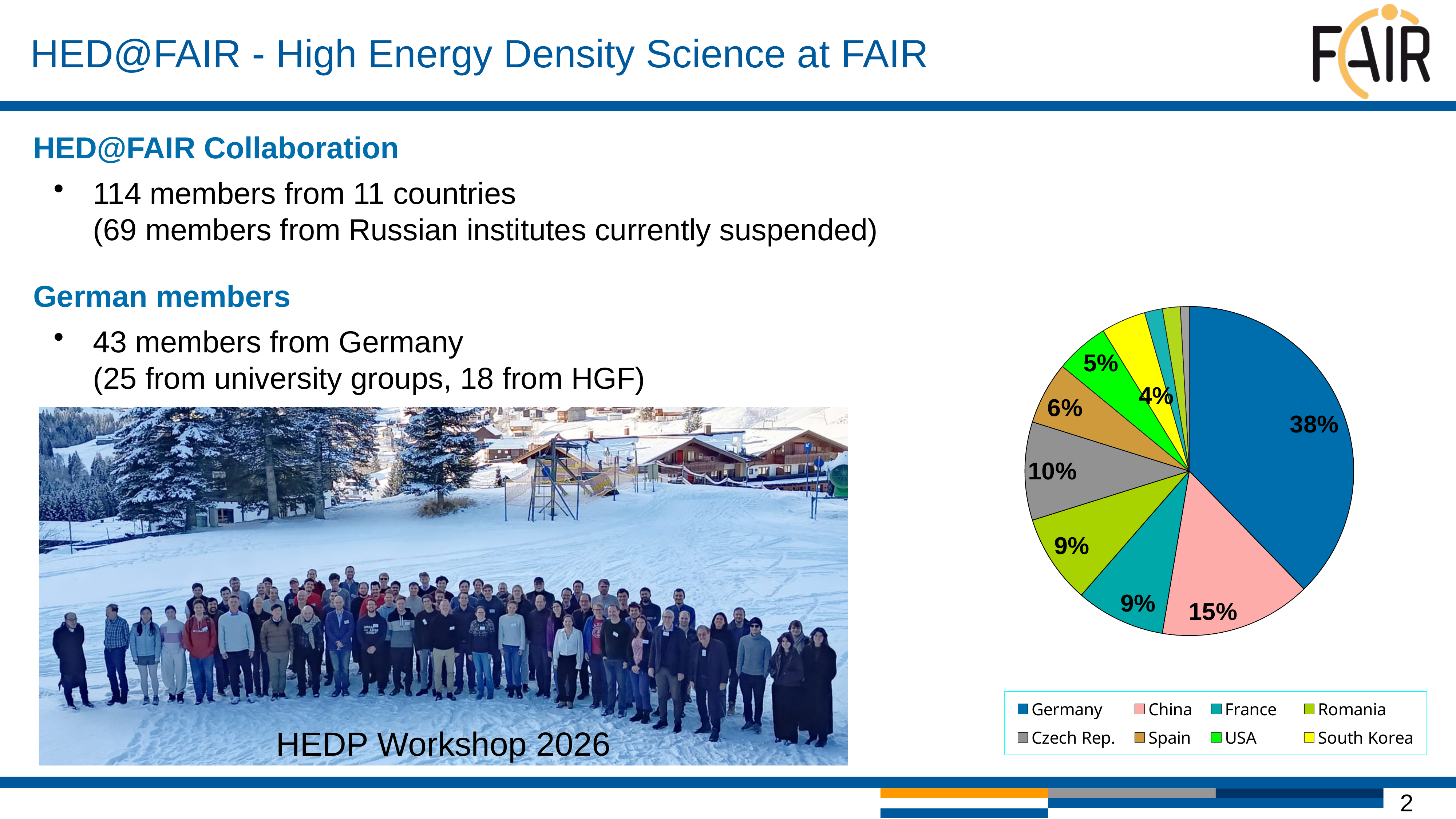
By how many percentage points does Germany's share exceed China's share in the pie chart? 23 percentage points What percentage is shown for the USA in the pie chart? 5% What percentage of the pie chart does Germany account for? 38% What colour is the Germany slice in the pie chart? Blue What percentage is shown for South Korea in the pie chart? 4% What share of the pie chart is labelled for China? 15% What type of chart is shown on the slide? Pie chart Which has the larger share in the pie chart, Czech Rep. or Spain? Czech Rep. How many entries does the legend of the pie chart list? 8 Which country has the largest slice in the pie chart? Germany What percentage is shown for Spain in the pie chart? 6% What percentage is shown for Czech Rep. in the pie chart? 10%